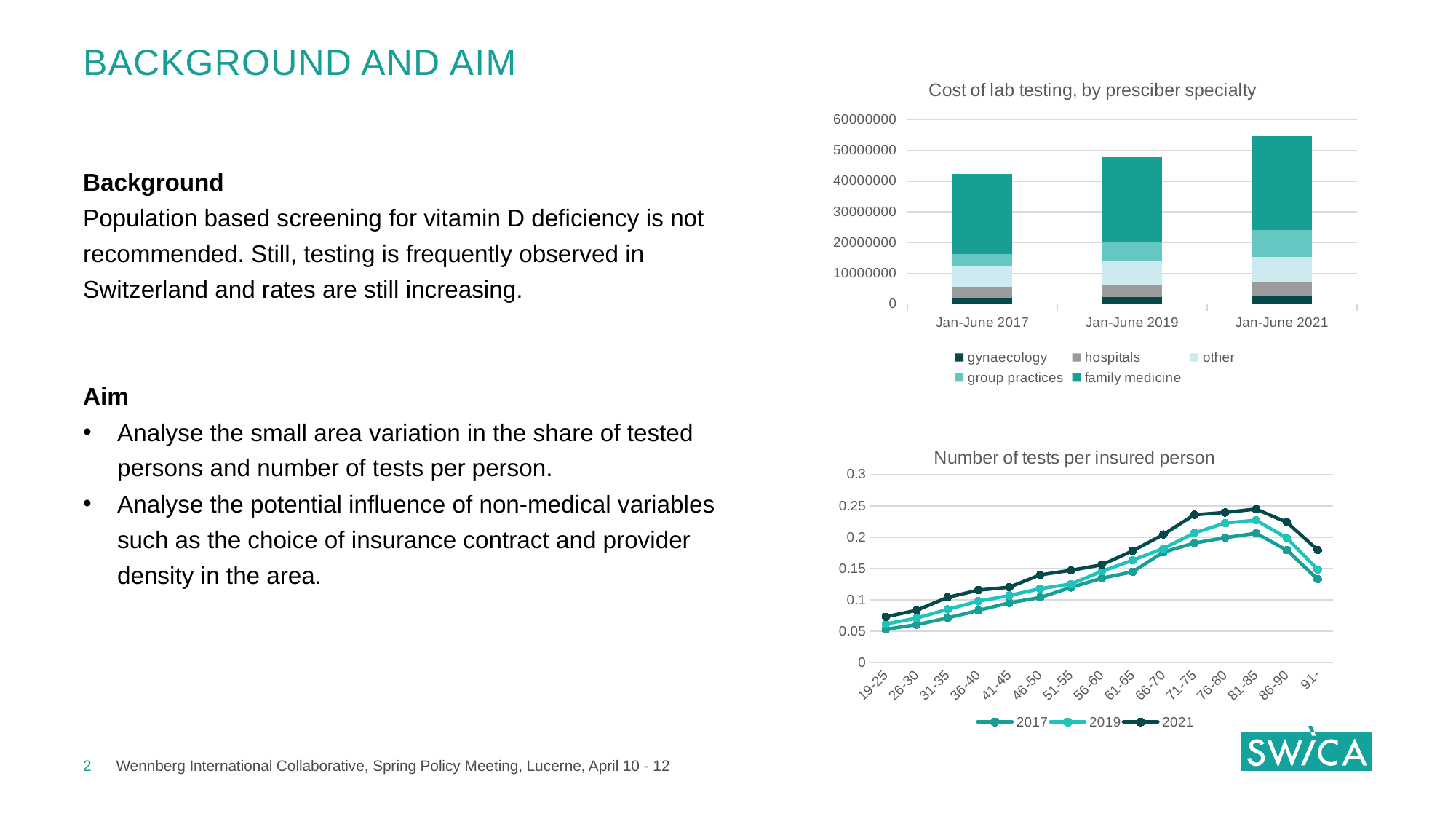
In the 'Number of tests per insured person' chart, which age group has the highest value for 2021? 81-85 In the 'Cost of lab testing, by presciber specialty' chart, which period has the highest total cost? Jan-June 2021 In the 'Number of tests per insured person' chart, is the 2021 value for 81-85 greater or less than 0.2? greater What type of chart is the 'Cost of lab testing, by presciber specialty' chart? stacked bar chart In the 'Cost of lab testing, by presciber specialty' chart, how many series does the legend list? 5 In the 'Cost of lab testing, by presciber specialty' chart, is the total for Jan-June 2021 greater or less than 50000000? greater In the 'Cost of lab testing, by presciber specialty' chart, how many periods are shown on the x axis? 3 In the 'Number of tests per insured person' chart, which is larger at age group 81-85: the 2017 value or the 2021 value? 2021 In the 'Number of tests per insured person' chart, how many series does the legend list? 3 What type of chart is the 'Number of tests per insured person' chart? line chart In the 'Number of tests per insured person' chart, how many age groups are shown on the x axis? 15 In the 'Cost of lab testing, by presciber specialty' chart, which specialty accounts for the largest segment of each bar? family medicine